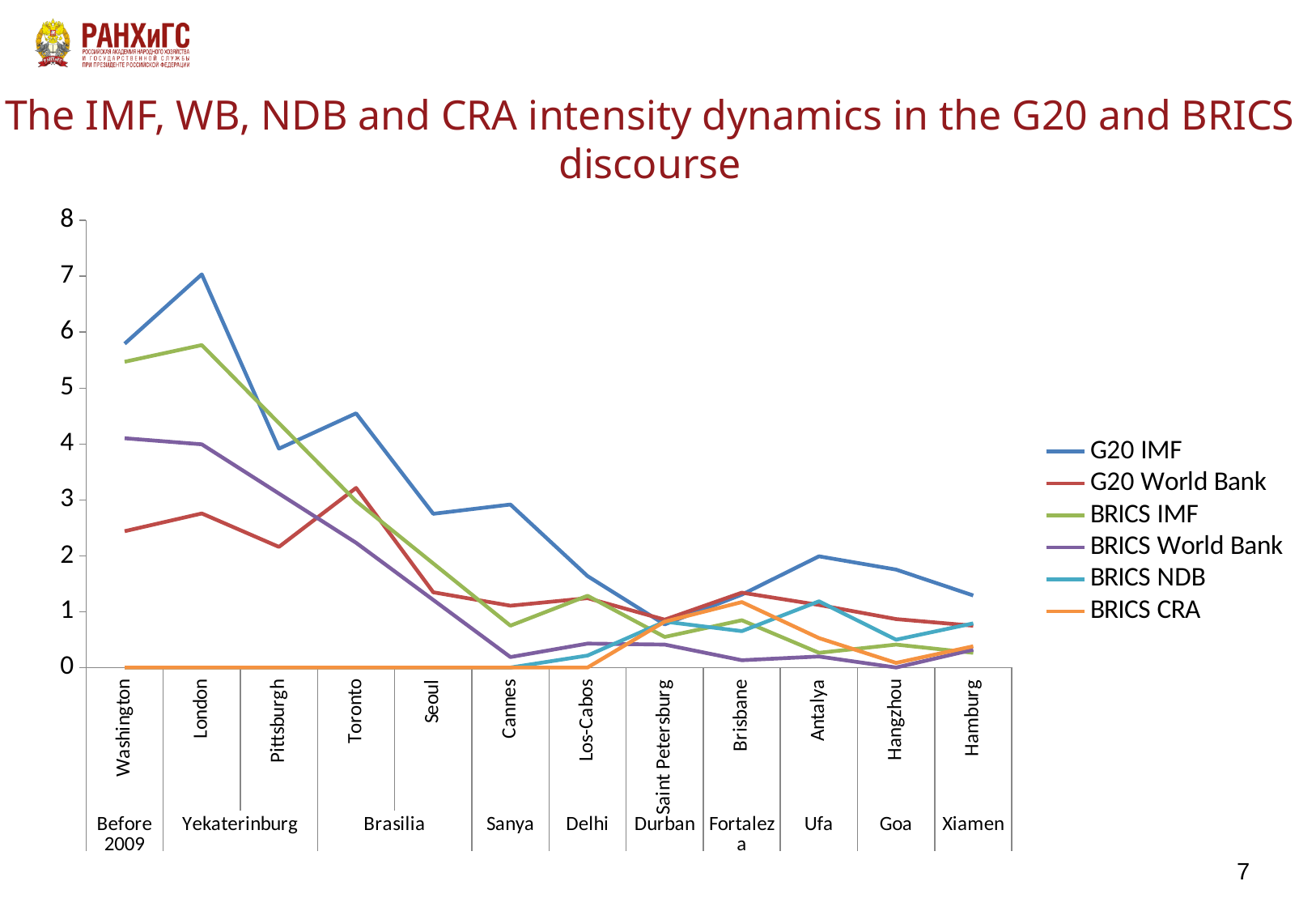
Is the value of BRICS World Bank at Washington greater or less than 3? greater Does the G20 IMF series rise or fall from London to Hamburg overall? fall At Antalya, which is larger: G20 IMF or BRICS IMF? G20 IMF At which summit does the G20 IMF series reach its highest value? London How many summit categories are plotted along the x axis? 12 How many series does the legend list? 6 Is the value of G20 IMF at London greater or less than 6? greater What kind of chart is shown on the slide? line chart Which series has the highest value at Toronto? G20 IMF What is the value of BRICS CRA at Washington? 0 Is the value of G20 IMF at Washington greater or less than 5? greater At Washington, which is larger: G20 IMF or G20 World Bank? G20 IMF